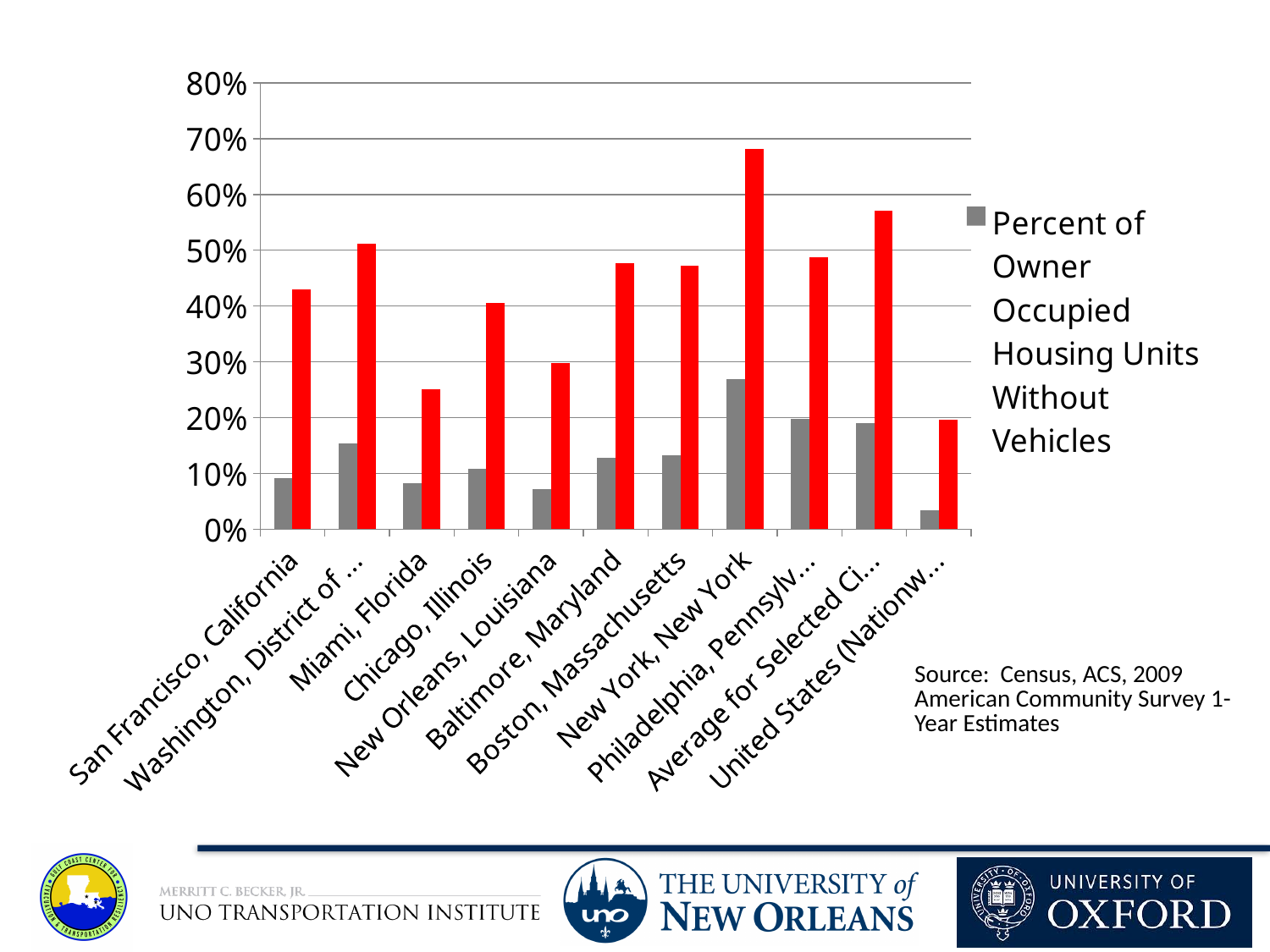
Which category has the shortest red bar in the chart? United States (Nationwide) Is the gray bar for New York, New York greater or less than 20%? greater What does the gray series in the legend represent? Percent of Owner Occupied Housing Units Without Vehicles Which category has the tallest red bar in the chart? New York, New York Which category has the tallest gray bar in the chart? New York, New York Which category has the shortest gray bar in the chart? United States (Nationwide) Is the gray bar for United States (Nationwide) greater or less than 10%? less Is the red bar for Miami, Florida greater or less than 30%? less Which has the larger red bar, New York, New York or Miami, Florida? New York, New York What kind of chart is shown on the slide? bar chart How many cities or categories are shown along the x axis of the chart? 11